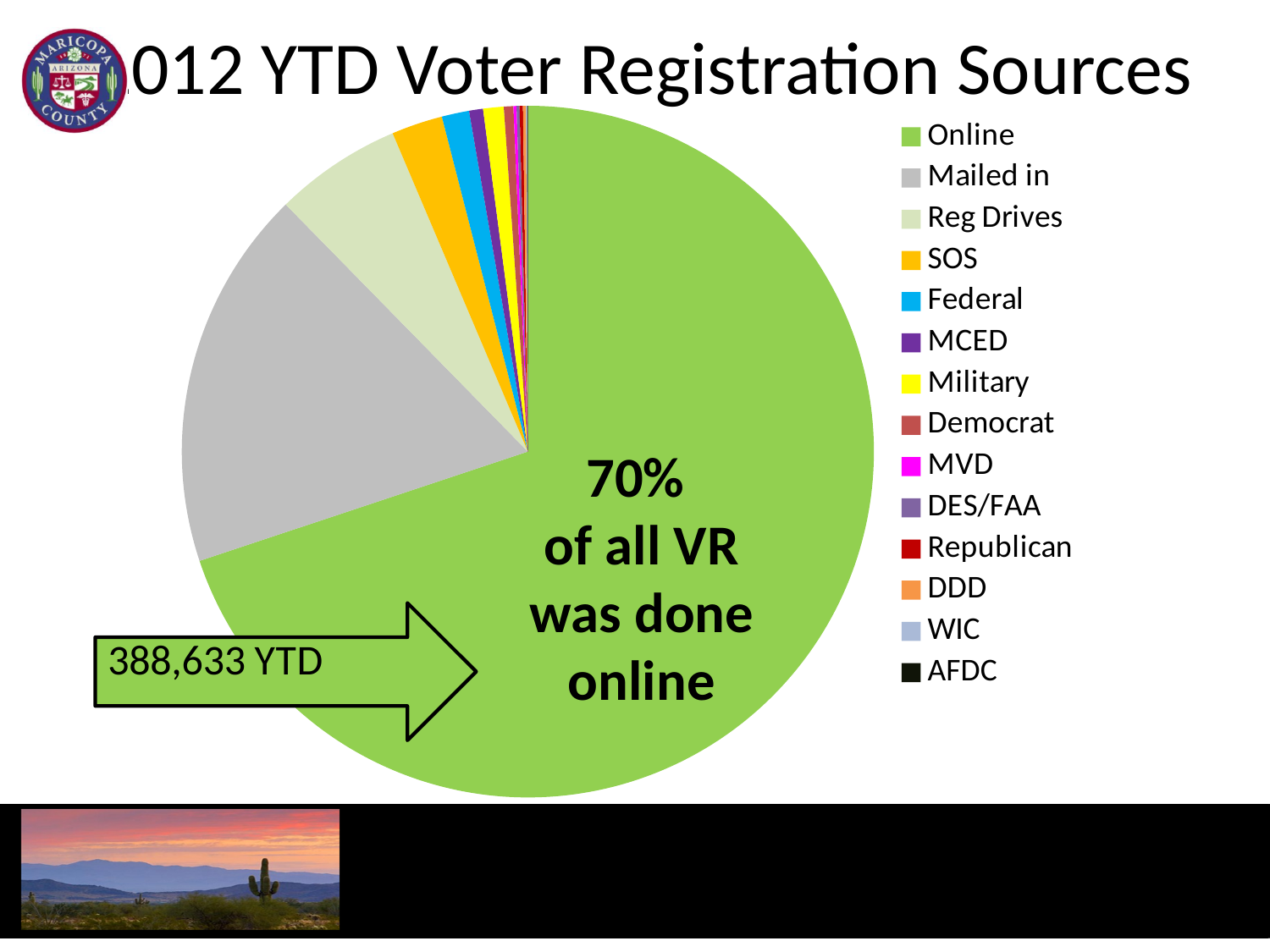
What colour is the Online slice? green How many categories does the legend list? 14 What kind of chart is shown on the slide? pie chart What number is shown in the arrow pointing at the pie? 388,633 YTD Which slice is larger, Mailed in or Reg Drives? Mailed in Which slice is larger, SOS or Federal? SOS Which category has the largest slice of the pie? Online Which category has the second-largest slice of the pie? Mailed in Which slice is larger, Reg Drives or SOS? Reg Drives According to the slide, what share of all voter registrations was done online? 70% Is the Online slice greater or less than half of the pie? greater